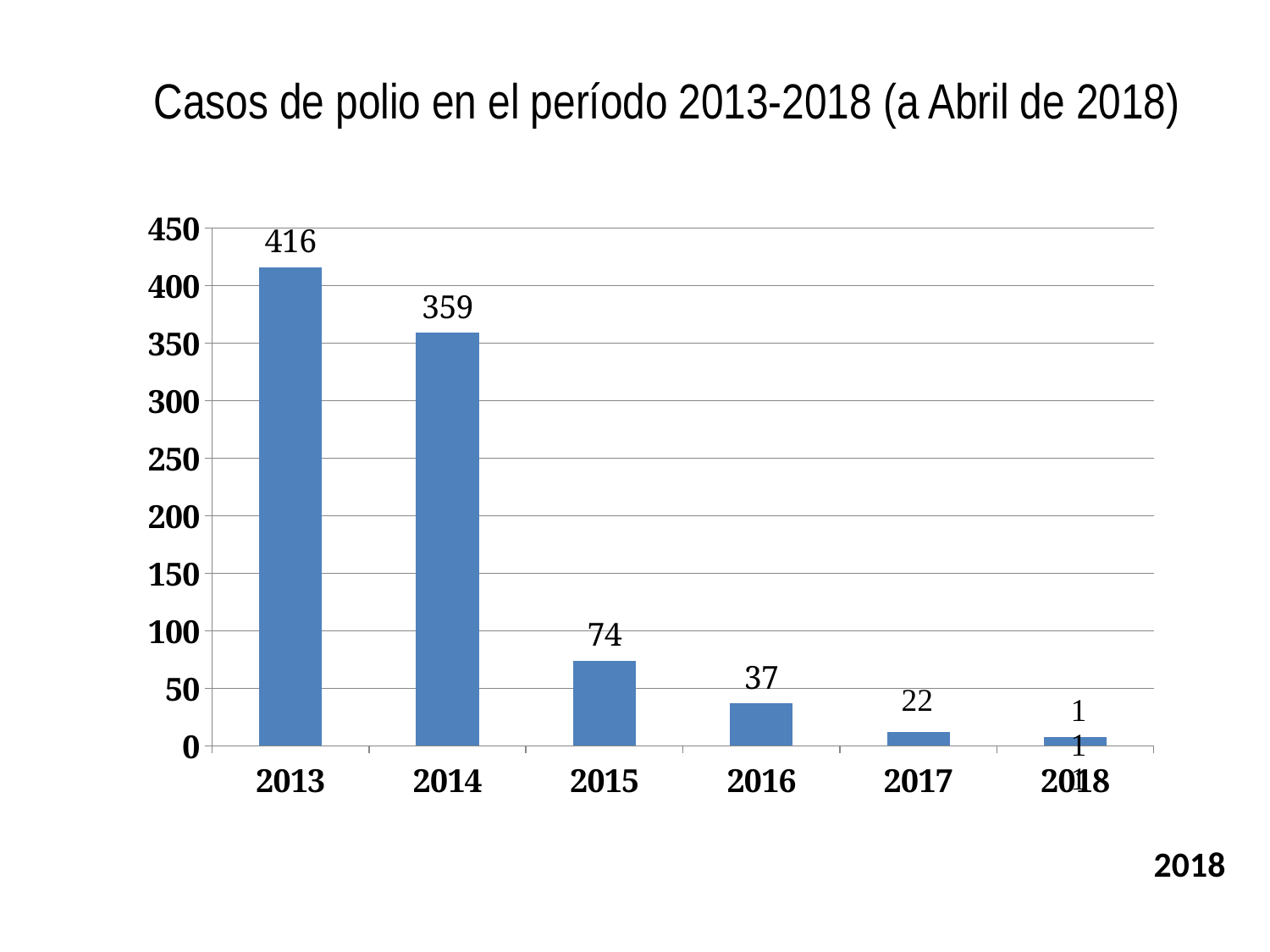
What is the title of the chart? Casos de polio en el período 2013-2018 (a Abril de 2018) What type of chart is shown on the slide? bar chart Which year has more polio cases, 2015 or 2016? 2015 How many polio cases are shown for 2014? 359 How many polio cases are shown for 2015? 74 How many polio cases are shown for 2017? 22 How many polio cases are shown for 2016? 37 Do the values rise or fall from 2013 to 2017? fall How many polio cases are shown for 2013? 416 Which year has the highest number of polio cases? 2013 How many years are shown on the x axis of the chart? 6 What is the difference in polio cases between 2013 and 2014? 57